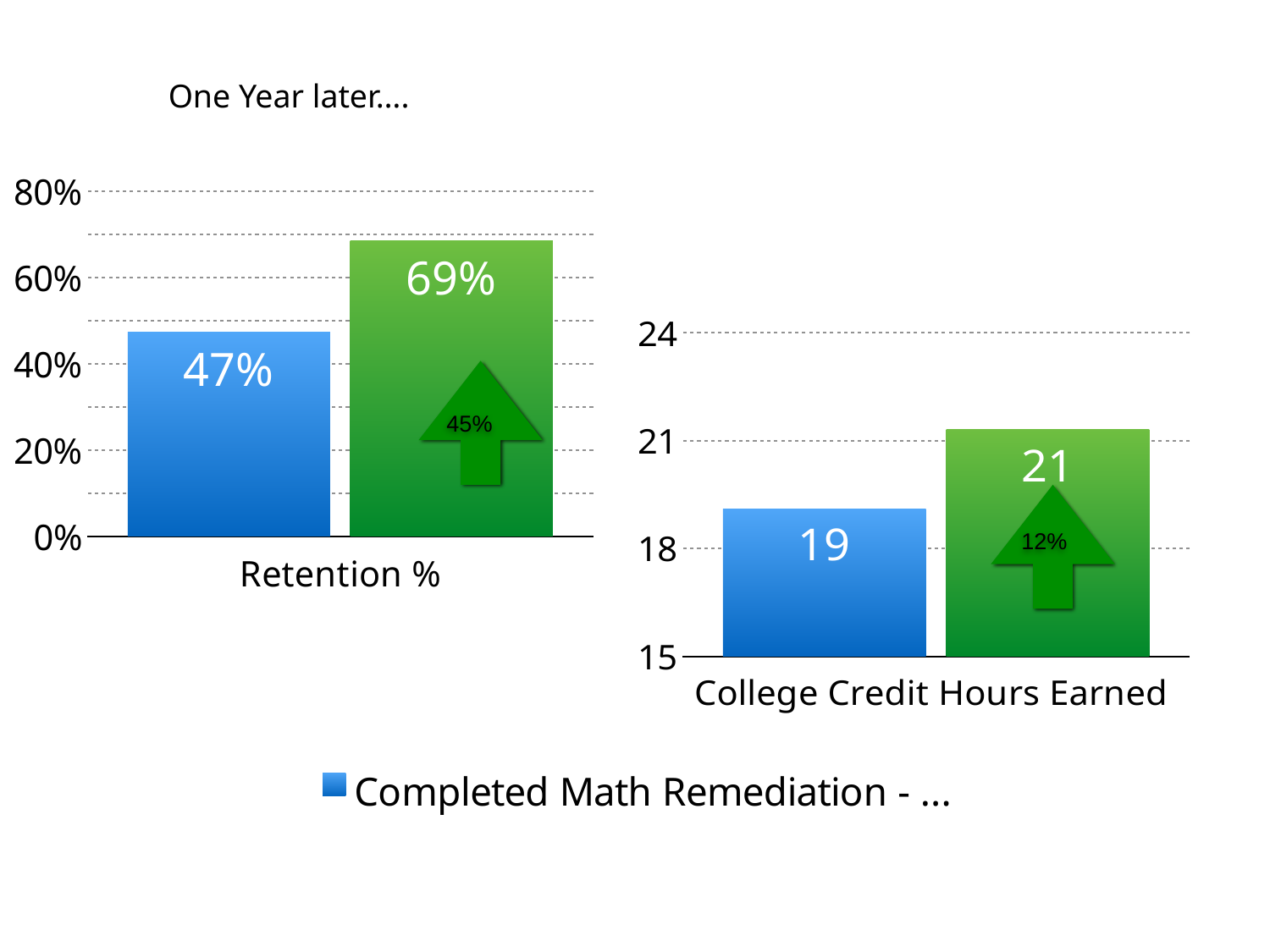
In the Retention % chart, what is the value of the green bar? 69% In the College Credit Hours Earned chart, what is the value of the green bar? 21 What is the title shown above the Retention % chart? One Year later.... In the College Credit Hours Earned chart, what is the difference between the green bar and the blue bar? 2 In the Retention % chart, which bar is higher, the blue bar or the green bar? the green bar In the Retention % chart, what is the value of the blue bar? 47% How many bars are plotted in the Retention % chart? 2 In the Retention % chart, what is the difference between the green bar and the blue bar? 22% In the College Credit Hours Earned chart, which bar is lower, the blue bar or the green bar? the blue bar In the Retention % chart, is the value of the blue bar greater or less than 60%? less What kind of chart is the College Credit Hours Earned chart? bar chart In the College Credit Hours Earned chart, what is the value of the blue bar? 19